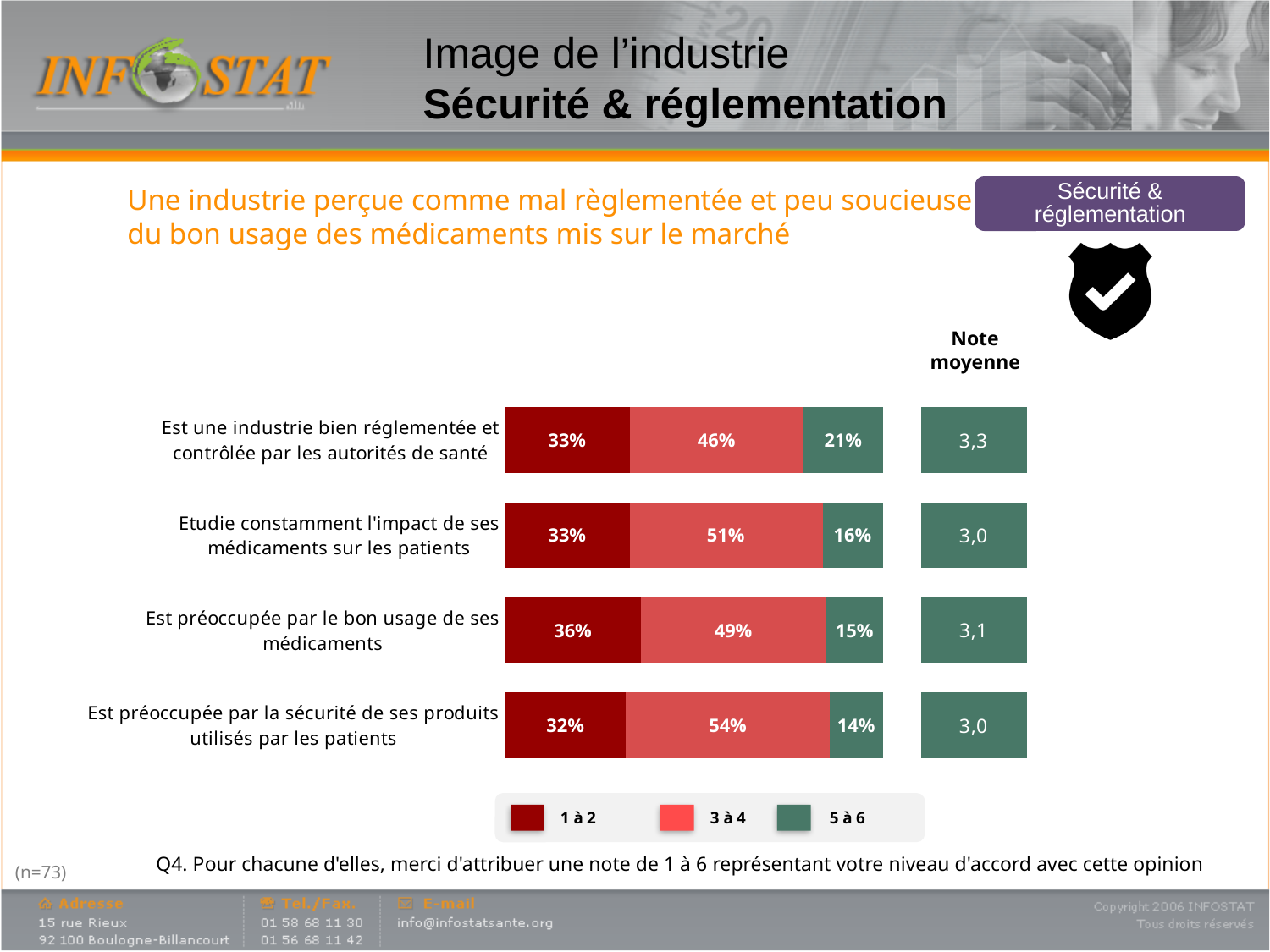
What colour represents the '1 à 2' series in the legend? dark red Which statement has the lowest '5 à 6' share? Est préoccupée par la sécurité de ses produits utilisés par les patients Which statement has the highest '3 à 4' share? Est préoccupée par la sécurité de ses produits utilisés par les patients What kind of chart is shown on the slide? stacked bar chart What is the 'Note moyenne' for 'Est une industrie bien réglementée et contrôlée par les autorités de santé'? 3,3 What is the '3 à 4' share for 'Est préoccupée par la sécurité de ses produits utilisés par les patients'? 54% What is the '1 à 2' share for 'Est préoccupée par le bon usage de ses médicaments'? 36% How many statements (categories) are plotted in the chart? 4 How many series does the legend list? 3 What is the '5 à 6' share for 'Est une industrie bien réglementée et contrôlée par les autorités de santé'? 21% Which is larger: the '1 à 2' share for 'Est préoccupée par le bon usage de ses médicaments' or for 'Est préoccupée par la sécurité de ses produits utilisés par les patients'? Est préoccupée par le bon usage de ses médicaments What is the difference between the '5 à 6' shares for 'Est une industrie bien réglementée et contrôlée par les autorités de santé' and 'Etudie constamment l'impact de ses médicaments sur les patients'? 5%